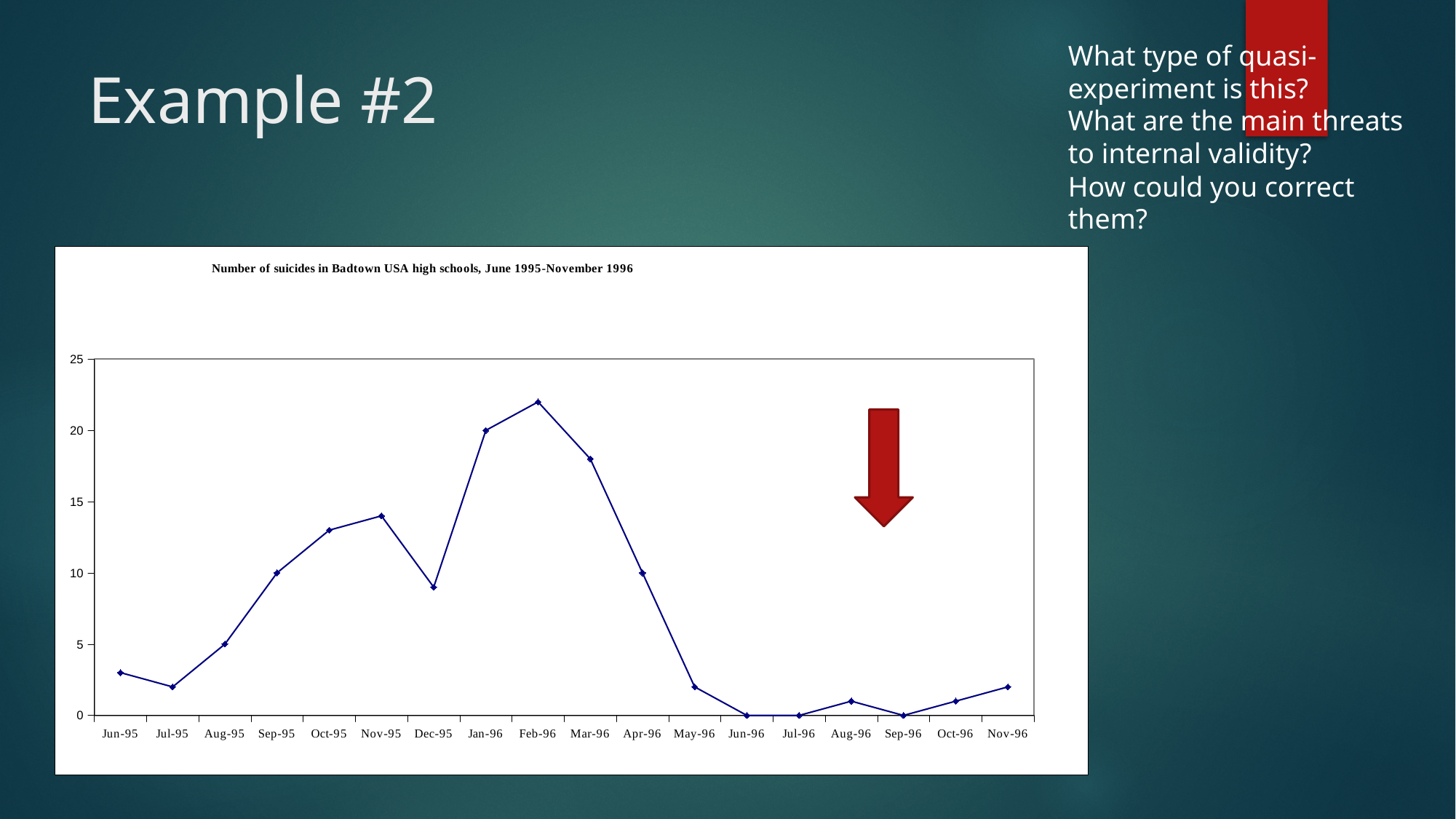
Is the value for Dec-95 greater or less than 10? less What is the title of the chart? Number of suicides in Badtown USA high schools, June 1995-November 1996 What kind of chart is shown on the slide? line chart How many monthly data points are plotted on the chart? 18 What is the value for Jan-96? 20 What is the value for Jun-96? 0 What is the value for Sep-95? 10 Is the value for Feb-96 greater or less than 20? greater Which month has the highest number of suicides? Feb-96 What is the value for Aug-95? 5 Which is larger, the value for Nov-95 or the value for Dec-95? Nov-95 What is the difference between the values for Jan-96 and Sep-95? 10